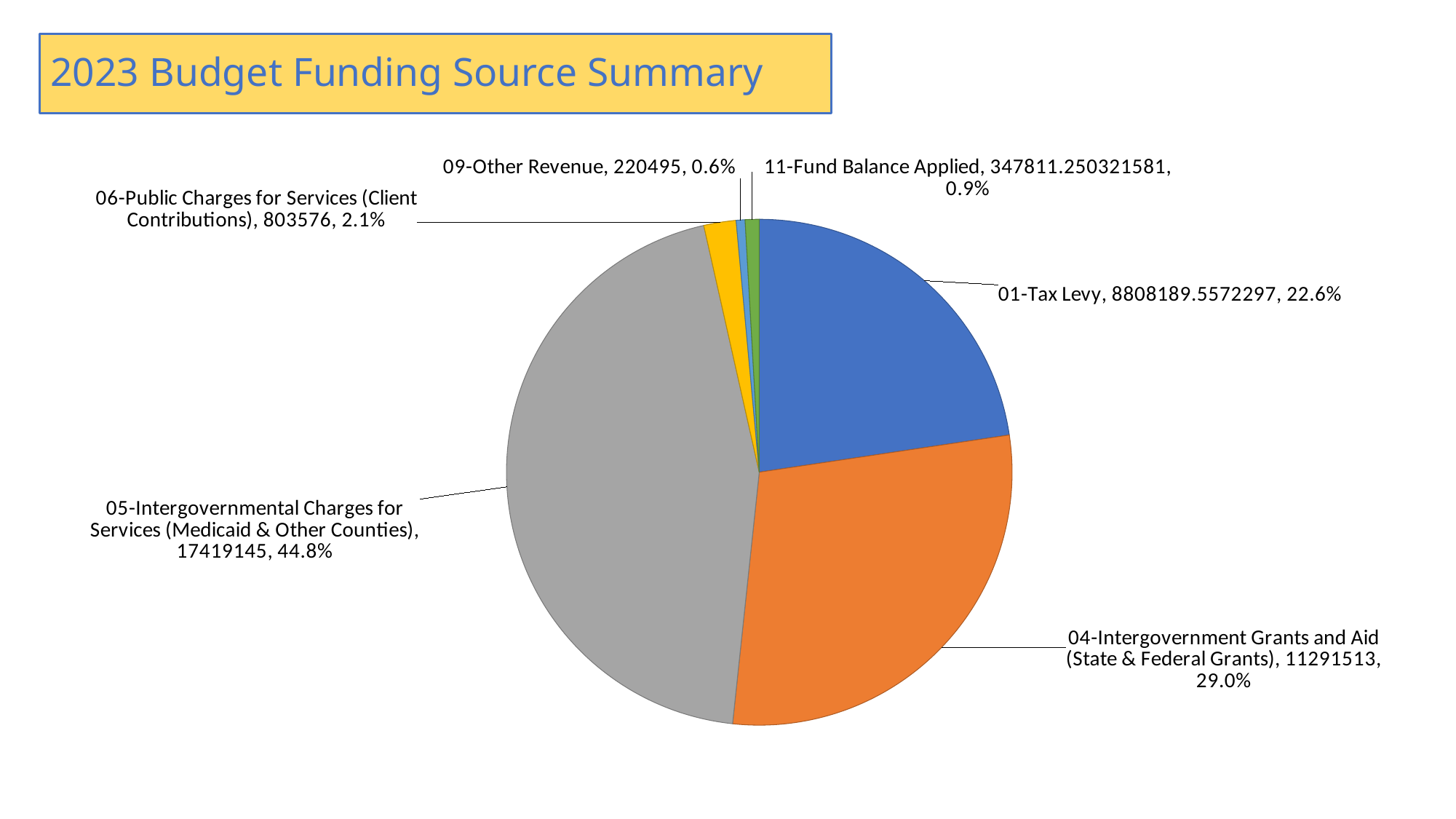
What share of the pie does 11-Fund Balance Applied represent? 0.9% What is the value for 05-Intergovernmental Charges for Services (Medicaid & Other Counties)? 17419145 What kind of chart is shown on the slide? pie chart What share of the pie does 01-Tax Levy represent? 22.6% How many slices does the pie chart have? 6 Which is larger, the share for 01-Tax Levy or the share for 04-Intergovernment Grants and Aid (State & Federal Grants)? 04-Intergovernment Grants and Aid (State & Federal Grants) What is the difference in percentage share between 05-Intergovernmental Charges for Services and 04-Intergovernment Grants and Aid? 15.8% What share of the pie does 06-Public Charges for Services (Client Contributions) represent? 2.1% What is the value for 04-Intergovernment Grants and Aid (State & Federal Grants)? 11291513 Which funding source has the largest slice? 05-Intergovernmental Charges for Services (Medicaid & Other Counties) What is the value for 09-Other Revenue? 220495 Which funding source has the smallest slice? 09-Other Revenue